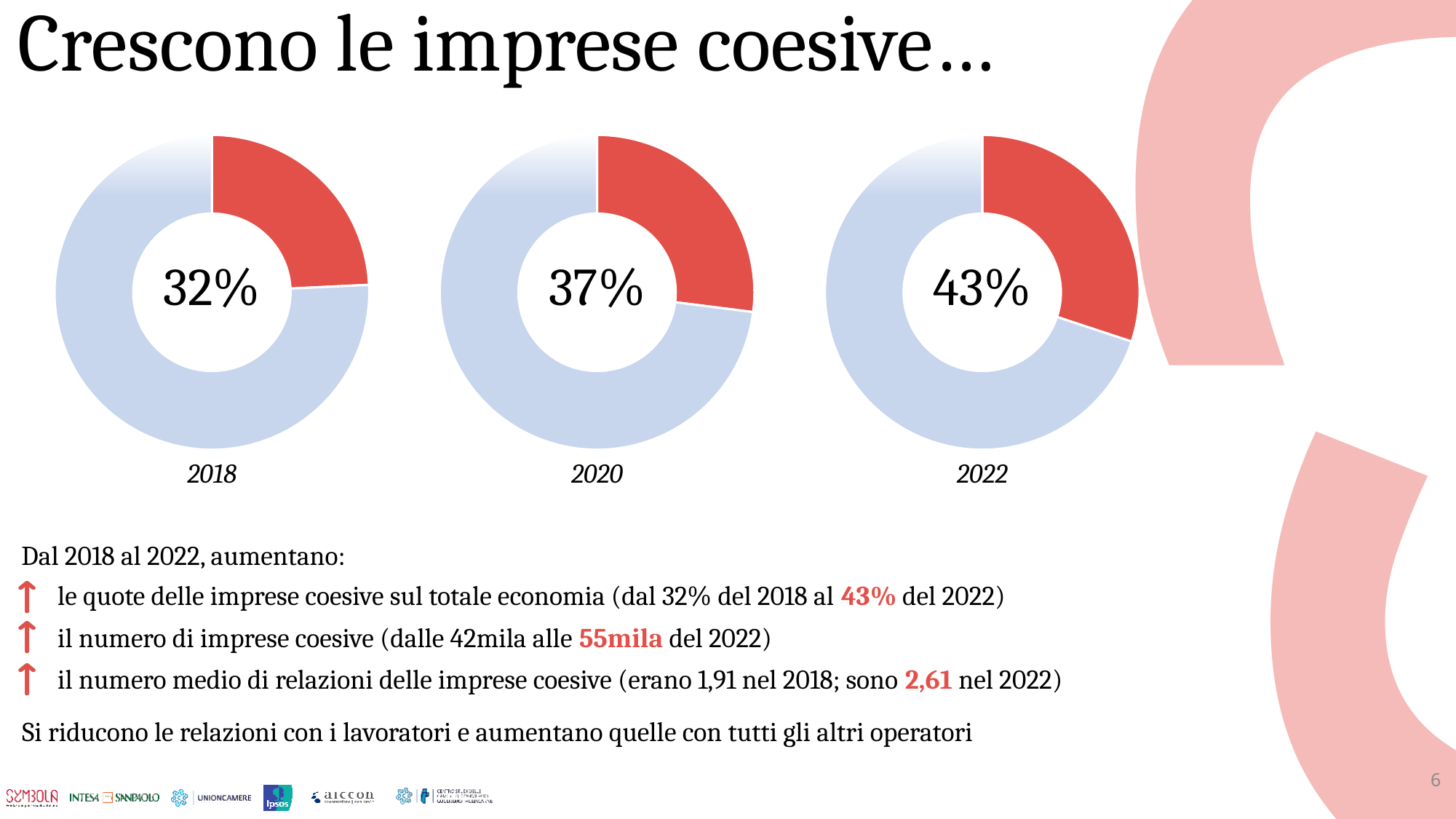
What is the difference in percentage points between the 2022 and 2018 donut charts? 11 Do the percentages shown in the donut charts rise or fall from 2018 to 2022? Rise Which is larger, the value in the 2020 donut chart or the value in the 2022 donut chart? 2022 What value is shown in the centre of the 2022 donut chart? 43% What kind of chart is used to show the percentages for 2018, 2020 and 2022? Donut (pie) chart How many donut charts are shown on the slide? 3 What share of coesive enterprises does the 2018 donut chart show? 32% Which year's donut chart shows the lowest percentage? 2018 What colour is the slice representing the coesive enterprises' share in each donut chart? Red What value is shown in the centre of the 2020 donut chart? 37% What is the difference in percentage points between the 2020 and 2018 donut charts? 5 Which year's donut chart shows the highest percentage? 2022